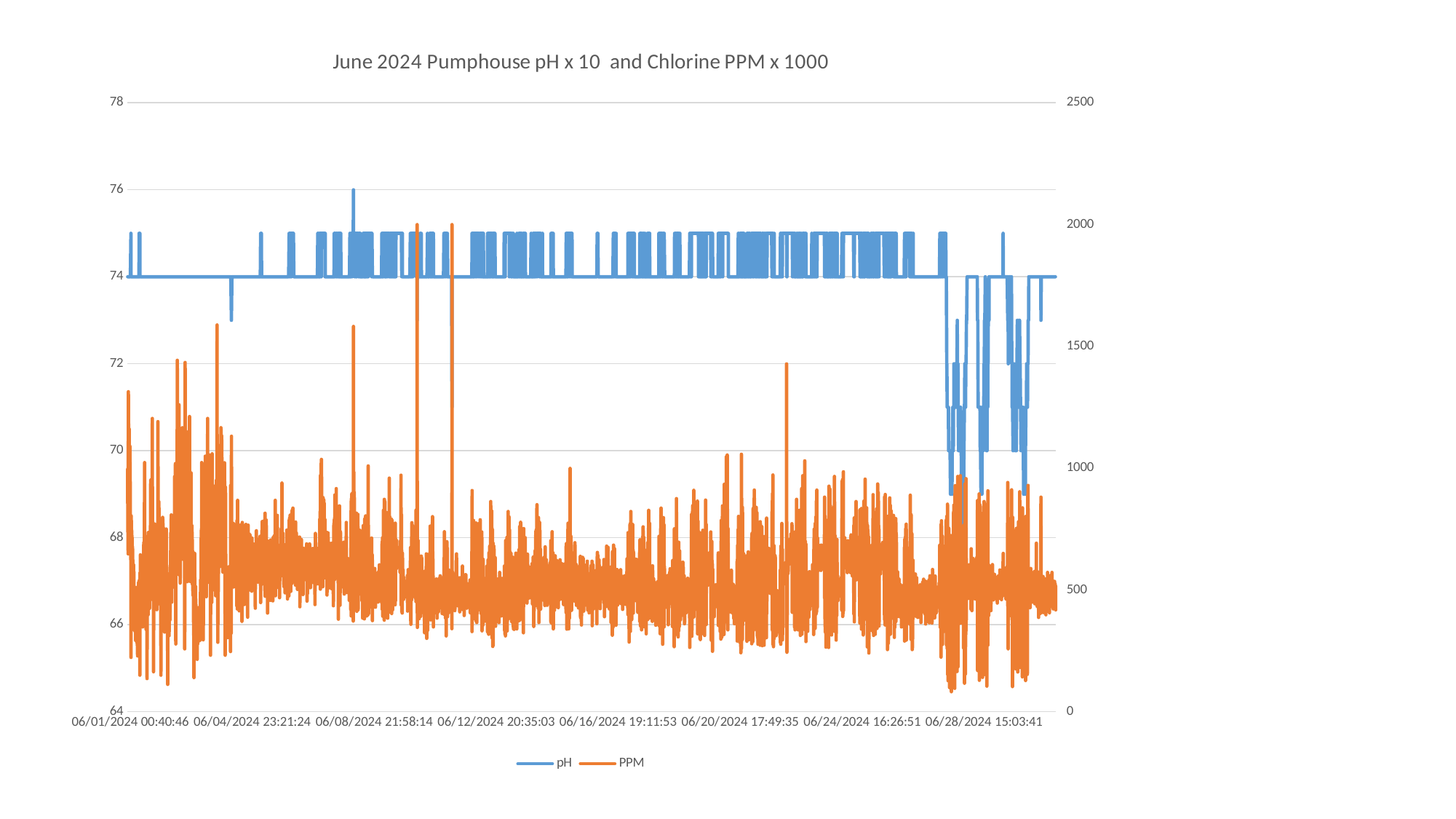
Does the pH line rise or fall in the period after 06/28/2024 compared with the rest of the month? fall What is the maximum value shown on the left vertical axis? 78 How many date labels are shown along the x axis? 8 Is the highest PPM value reached during the month greater or less than 1500? greater What is the title of the chart? June 2024 Pumphouse pH x 10 and Chlorine PPM x 1000 What is the maximum value shown on the right vertical axis? 2500 How many series does the legend list? 2 Is the pH value at the start of the month (06/01/2024) greater or less than 72? greater Is the highest pH value on the chart greater or less than 78? less What kind of chart is shown on the slide? line chart